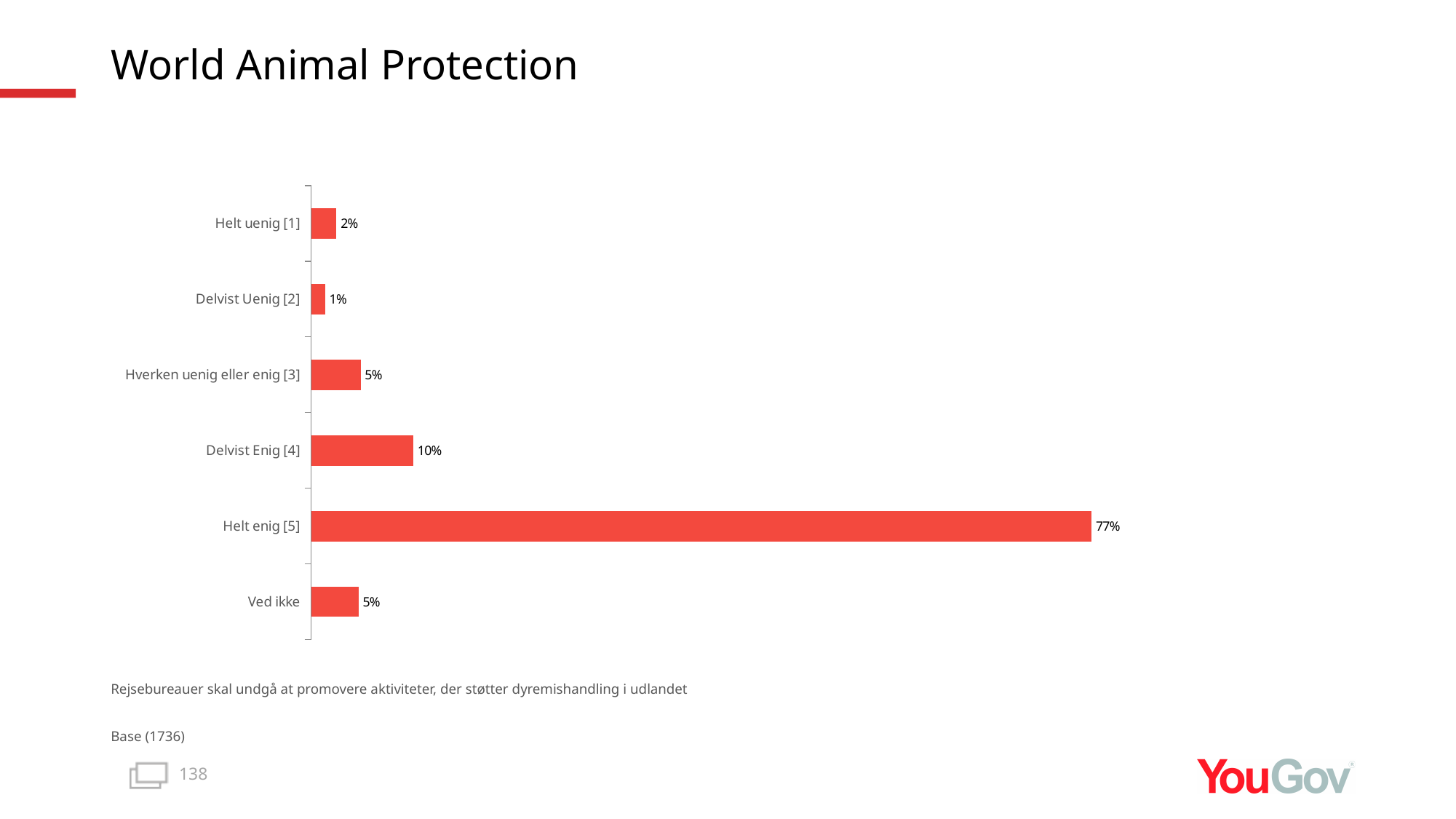
What kind of chart is shown on the slide? Bar chart What percentage is shown for "Helt uenig [1]"? 2% What is the value shown for "Delvist Enig [4]"? 10% What is the title of the slide? World Animal Protection Which category has the lowest value? Delvist Uenig [2] How many categories are shown in the chart? 6 Which is larger, the value for "Hverken uenig eller enig [3]" or the value for "Helt uenig [1]"? Hverken uenig eller enig [3] What is the difference between the values for "Helt enig [5]" and "Delvist Enig [4]"? 67% Which category has the highest value? Helt enig [5] What is the value for "Ved ikke"? 5% What percentage of respondents answered "Helt enig [5]"? 77% What is the base (number of respondents) stated on the slide? 1736